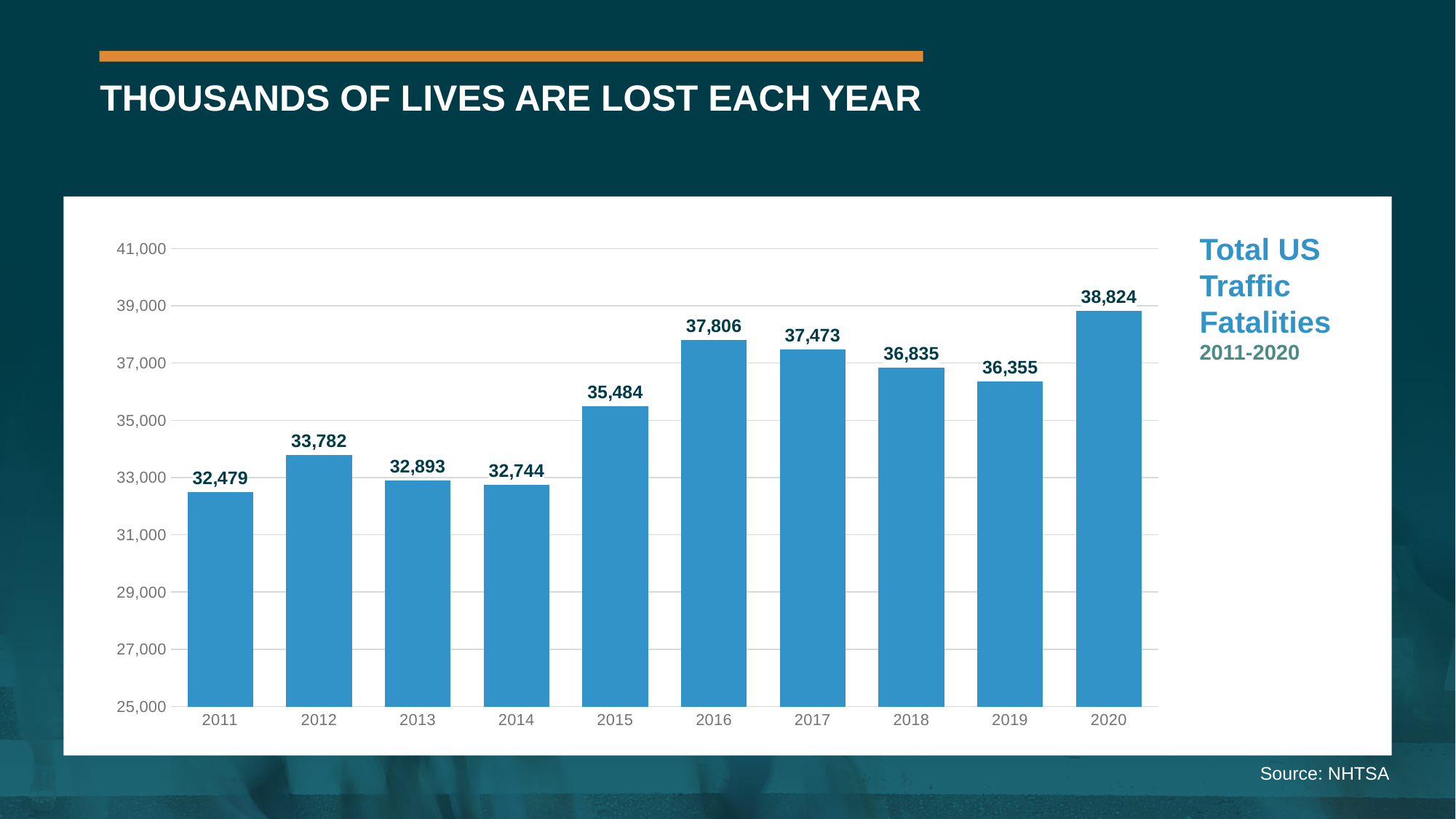
What value is shown for 2011? 32,479 Which year had the highest number of traffic fatalities? 2020 Overall, do the values rise or fall from 2011 to 2020? Rise What is the source cited for the chart data? NHTSA How many years are shown on the x axis? 10 What was the total number of US traffic fatalities in 2016? 37,806 Which year had the lowest number of traffic fatalities? 2011 What is the difference between the 2016 and 2017 values? 333 What kind of chart is shown on the slide? Bar chart Which year had more fatalities, 2013 or 2014? 2013 Is the value for 2015 greater or less than 35,000? greater How many more fatalities were there in 2020 than in 2019? 2,469